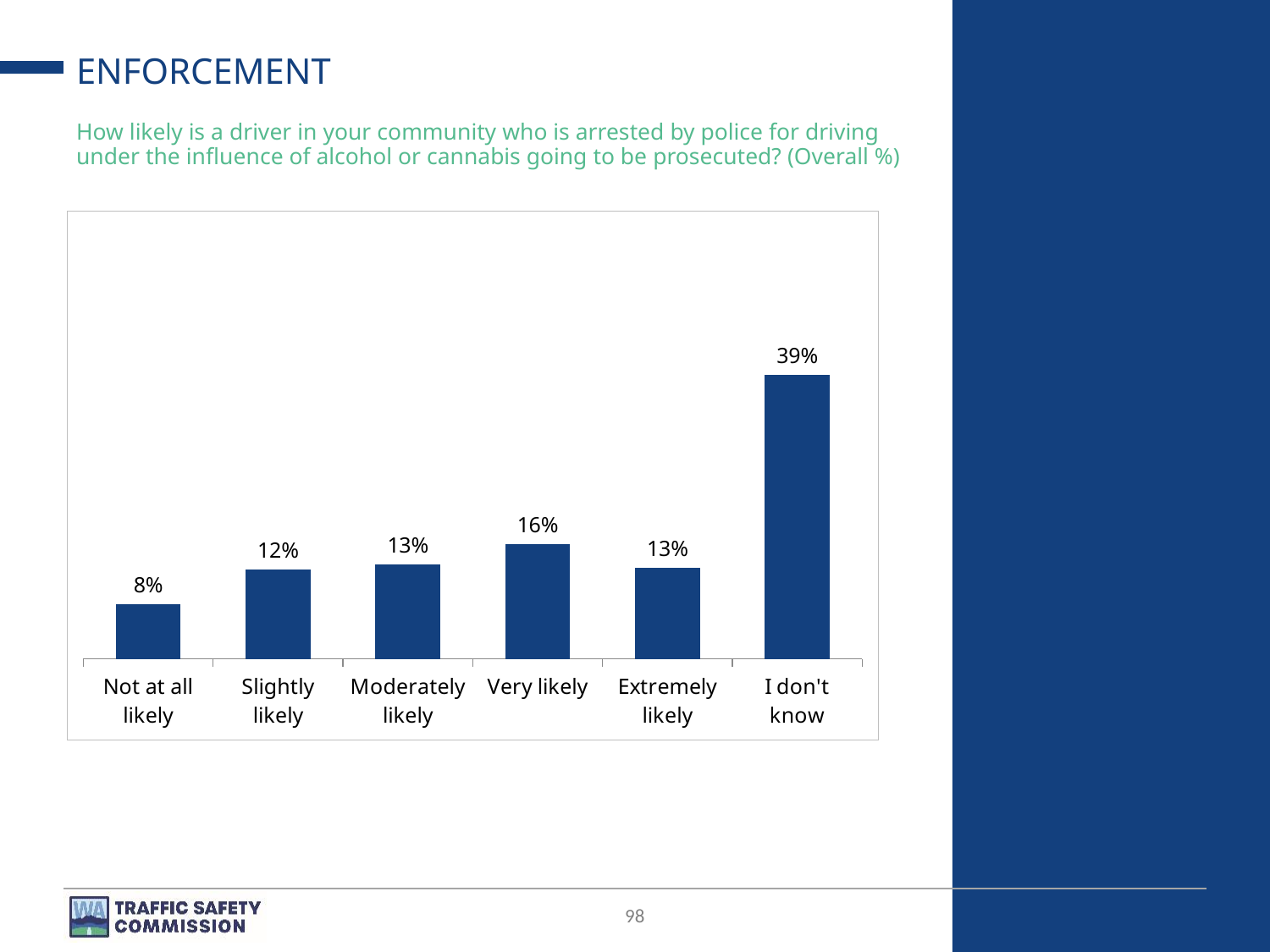
What is the value for "Not at all likely"? 8% What kind of chart is shown on the slide? Bar chart Which is larger, the value for "Very likely" or the value for "Extremely likely"? Very likely What percentage of respondents answered "I don't know"? 39% What is the difference between the values for "I don't know" and "Very likely"? 23 percentage points What is the value for "Slightly likely"? 12% Which category has the lowest value? Not at all likely Which category has the highest value? I don't know What is the value for "Very likely"? 16% Do the values for "Moderately likely" and "Extremely likely" match? Yes, both are 13% What is the difference between the values for "Slightly likely" and "Not at all likely"? 4 percentage points How many categories are shown on the x axis? 6